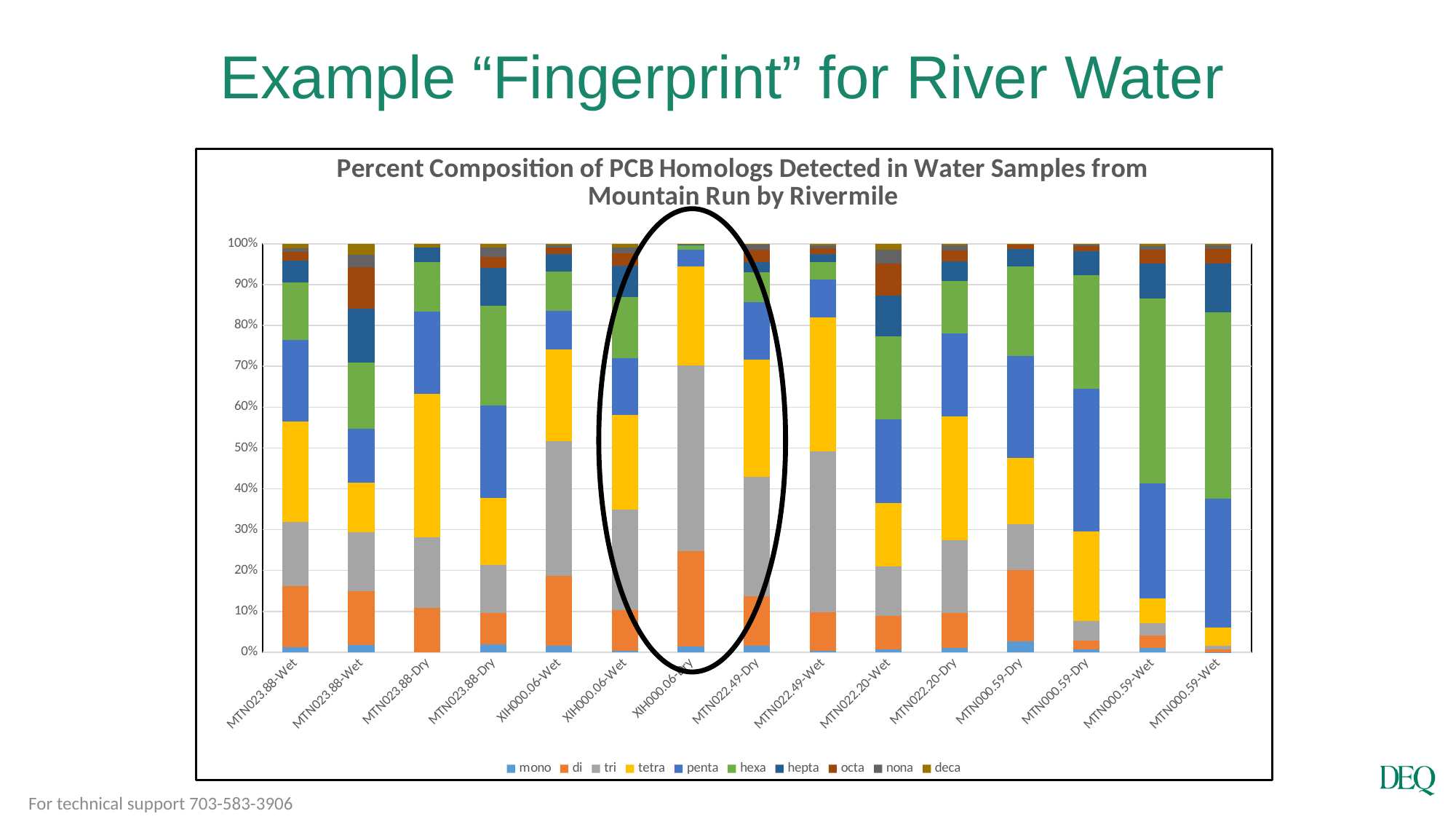
Is the tetra segment in the MTN022.49-Wet bar greater or less than 30% of the bar? greater In the MTN022.49-Wet bar, which segment is larger, tetra or penta? tetra What is the title of the chart? Percent Composition of PCB Homologs Detected in Water Samples from Mountain Run by Rivermile Which bar is circled on the chart? XIH000.06-Dry What kind of chart is shown on the slide? Stacked bar chart How many bars are plotted in the chart? 15 Which bar has the largest tri (grey) segment? XIH000.06-Dry Is the tri segment in the XIH000.06-Dry bar greater or less than 40% of the bar? greater How many series does the legend list? 10 What is the total height of each stacked bar? 100% In the XIH000.06-Dry bar, which segment is larger, tri or tetra? tri Is the di segment in the XIH000.06-Dry bar greater or less than 20% of the bar? greater